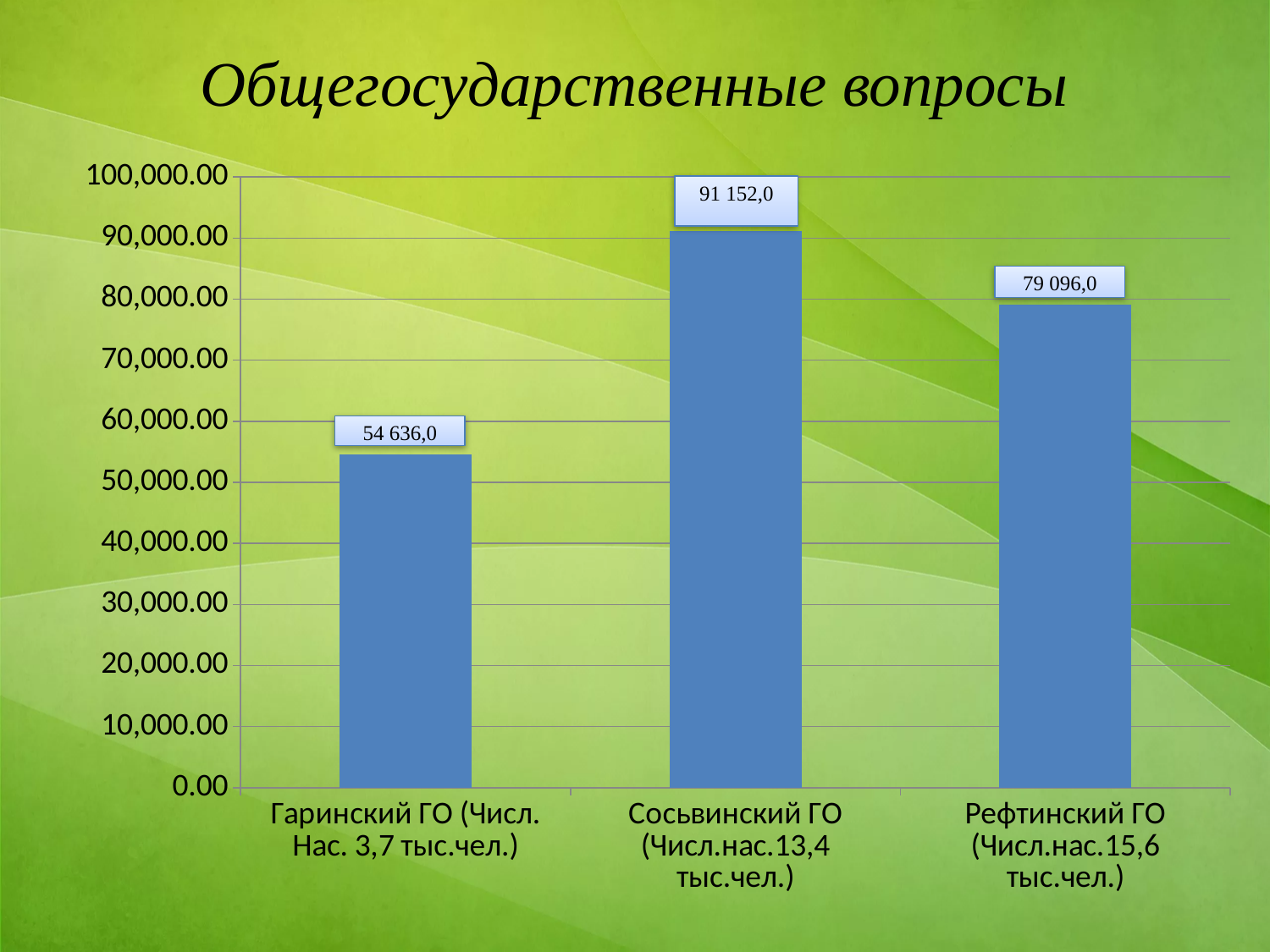
Which category has the lowest value? Гаринский ГО Is the value for Гаринский ГО greater or less than 60,000.00? less Which is larger, the value for Рефтинский ГО or the value for Гаринский ГО? Рефтинский ГО What is the title of the slide? Общегосударственные вопросы What kind of chart is shown on the slide? bar chart What is the difference between the values for Сосьвинский ГО and Рефтинский ГО? 12 056,0 Which category has the highest value? Сосьвинский ГО What is the value for Сосьвинский ГО? 91 152,0 How many categories are shown in the chart? 3 What is the value for Рефтинский ГО? 79 096,0 What is the value for Гаринский ГО? 54 636,0 What is the difference between the values for Сосьвинский ГО and Гаринский ГО? 36 516,0